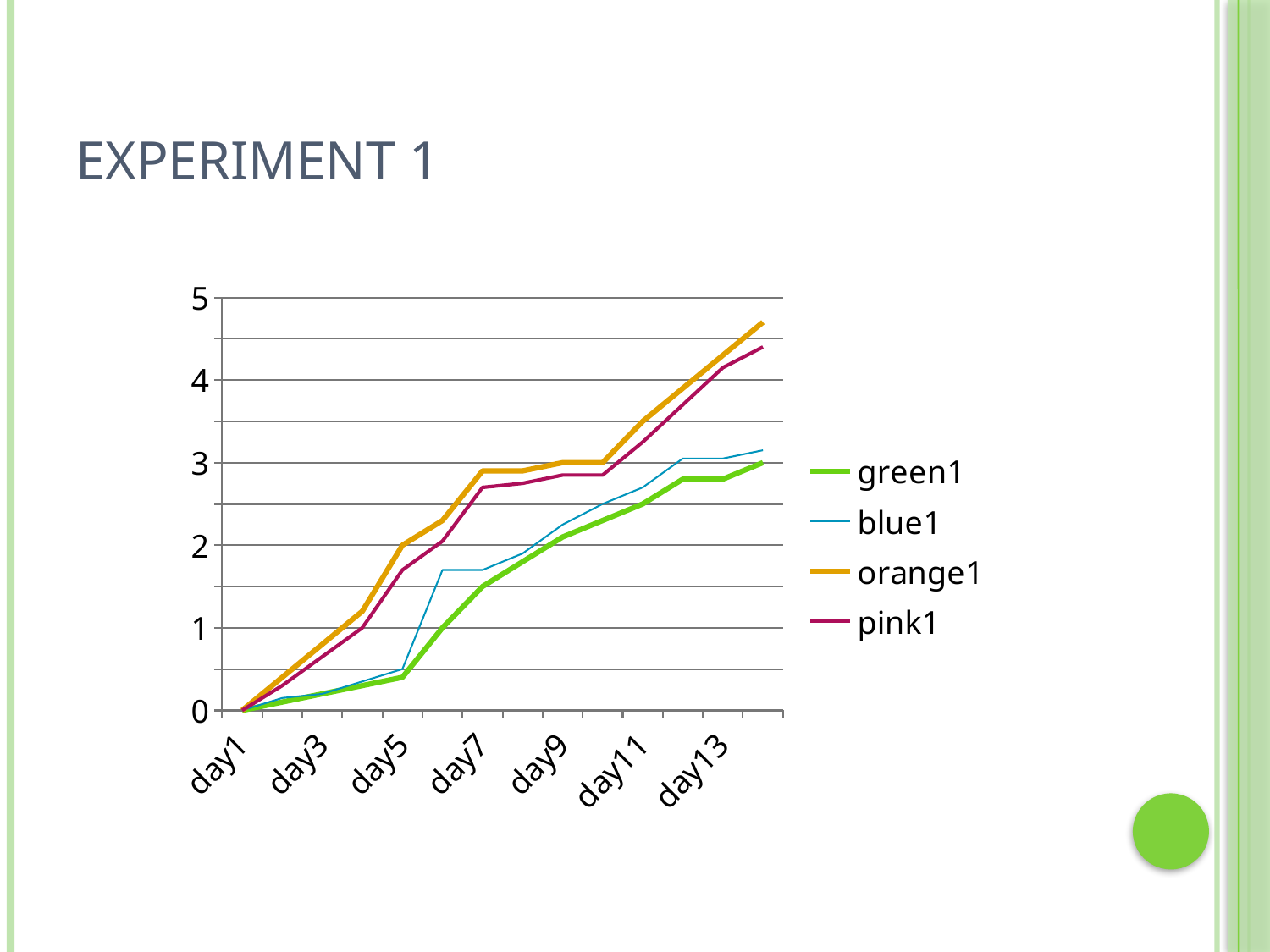
Is the value for pink1 at day5 greater or less than 1? greater Which series is drawn with the thickest green line in the legend? green1 Do the values of the orange1 series rise or fall along the x axis? rise Which series is lowest at the last point on the x axis? green1 What is the value for green1 at day1? 0 Is the value for orange1 at the last point greater or less than 4? greater At day7, which series has the larger value, orange1 or blue1? orange1 How many series does the legend list? 4 What kind of chart is shown on the slide? line chart Which series is highest at the last point on the x axis? orange1 What is the title of the slide containing the chart? EXPERIMENT 1 Is the value for green1 at day7 greater or less than 2? less